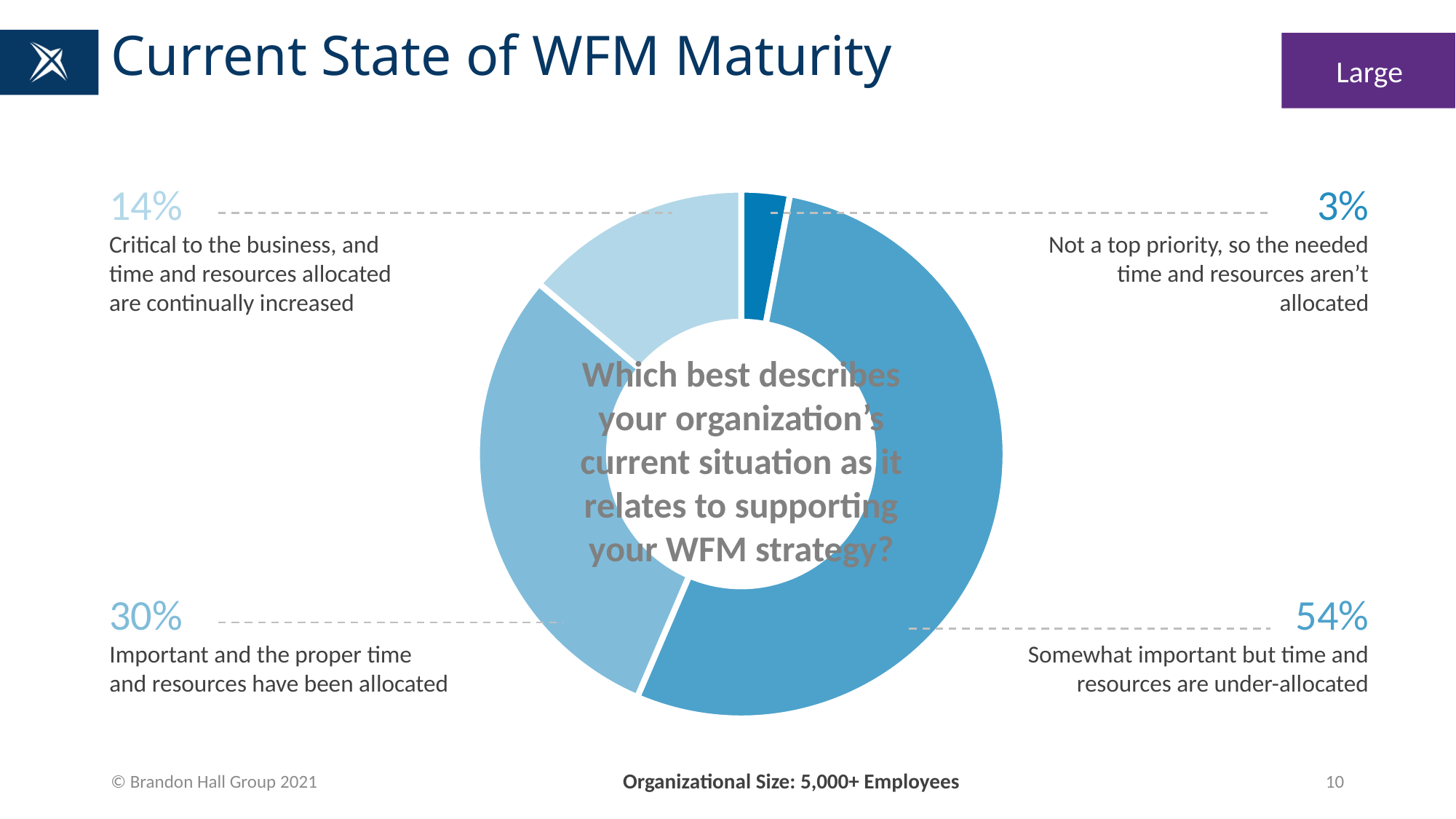
What kind of chart is shown on the slide? Pie chart (donut) Which response has the largest share of the chart? Somewhat important but time and resources are under-allocated What percentage of respondents said WFM is important and the proper time and resources have been allocated? 30% What percentage of respondents said WFM is somewhat important but time and resources are under-allocated? 54% Which is larger: the share for 'Critical to the business' or the share for 'Not a top priority'? Critical to the business What question is written in the center of the chart? Which best describes your organization's current situation as it relates to supporting your WFM strategy? Which response has the smallest share of the chart? Not a top priority, so the needed time and resources aren't allocated What percentage of respondents said WFM is not a top priority, so the needed time and resources aren't allocated? 3% How many response categories are shown in the chart? 4 What organizational size does the chart cover, according to the footer? 5,000+ Employees What is the difference in percentage points between the 'Somewhat important but time and resources are under-allocated' and 'Important and the proper time and resources have been allocated' responses? 24 What percentage of respondents said WFM is critical to the business, and time and resources allocated are continually increased? 14%